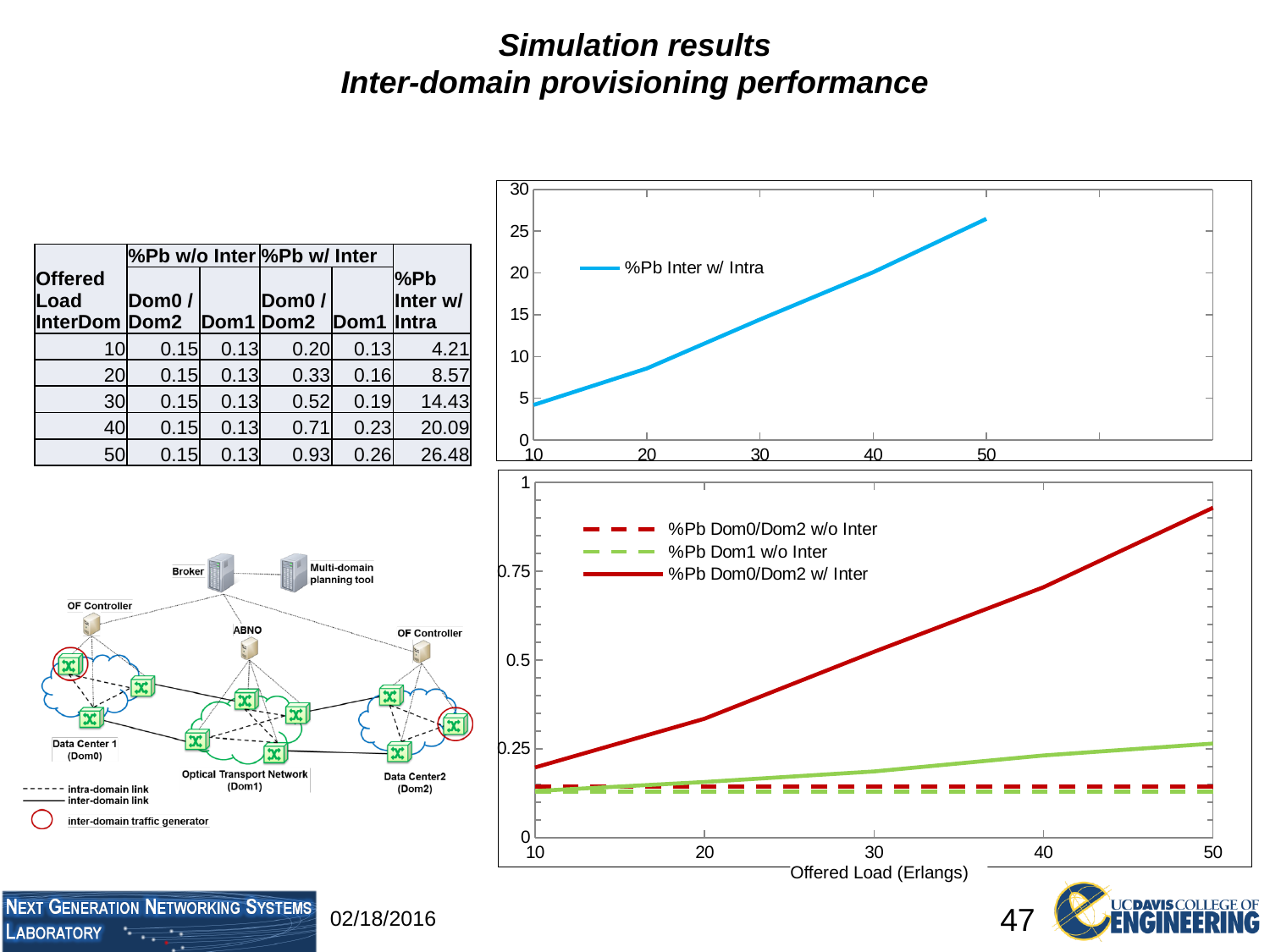
In the top chart, is the value of %Pb Inter w/ Intra at an offered load of 10 greater or less than 5? less In the bottom chart, does %Pb Dom0/Dom2 w/o Inter rise, fall or stay flat as the offered load increases? stay flat In the bottom chart, is the value of %Pb Dom0/Dom2 w/ Inter at an offered load of 50 greater or less than 0.75? greater What is the x-axis label of the bottom chart? Offered Load (Erlangs) What is the name of the series shown in the legend of the top chart? %Pb Inter w/ Intra What kind of chart is the top chart on the slide? line chart How many series does the legend of the bottom chart list? 3 In the bottom chart, at an offered load of 50, which is larger: %Pb Dom0/Dom2 w/ Inter or %Pb Dom0/Dom2 w/o Inter? %Pb Dom0/Dom2 w/ Inter In the top chart, is the value of %Pb Inter w/ Intra at an offered load of 50 greater or less than 25? greater In the top chart, does %Pb Inter w/ Intra rise or fall as the offered load increases from 10 to 50? rise In the bottom chart, which legend series has the highest value at an offered load of 50? %Pb Dom0/Dom2 w/ Inter According to the table on the slide, what is the value of %Pb Inter w/ Intra plotted in the top chart at an offered load of 50? 26.48